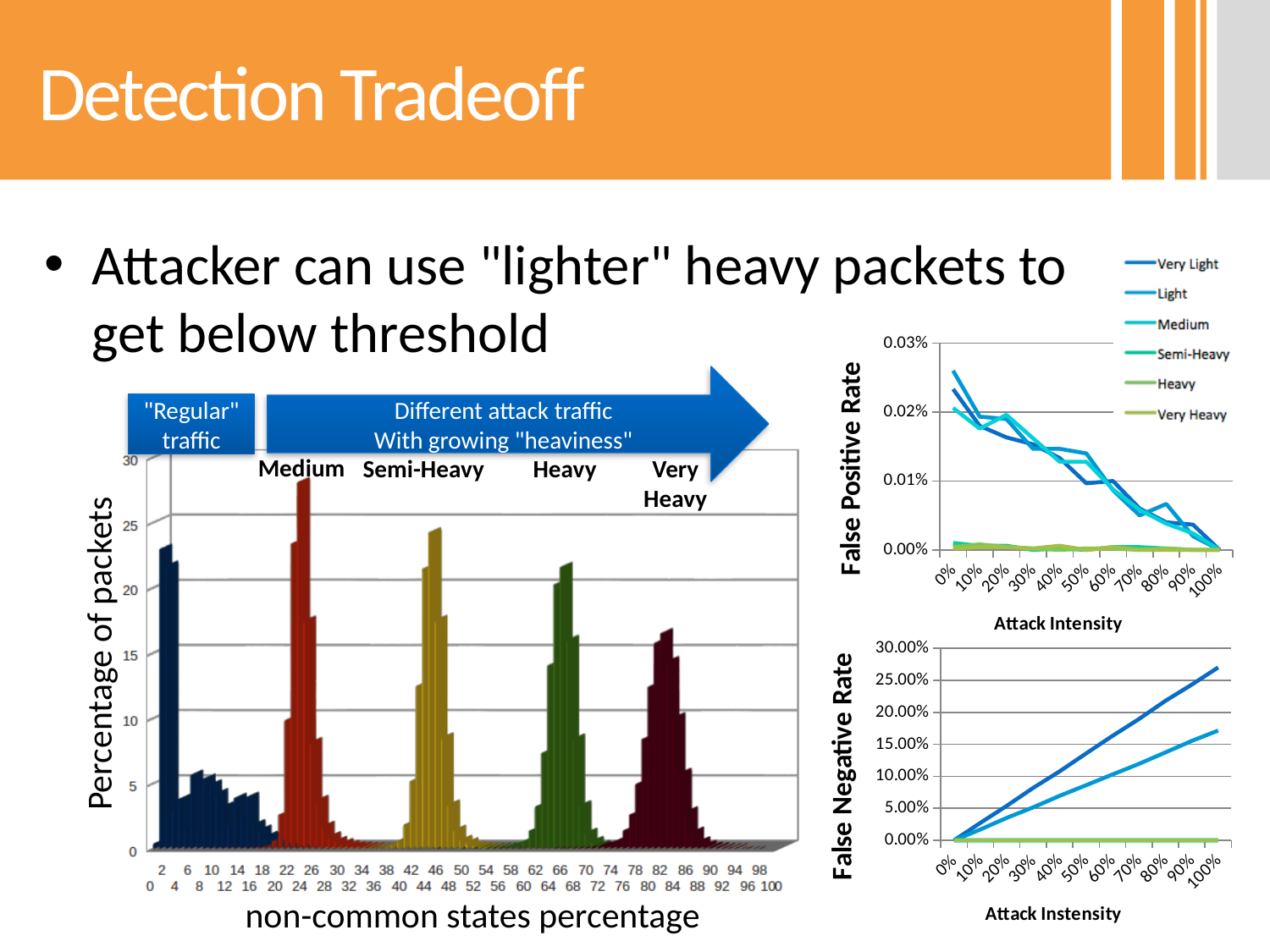
In the False Negative Rate chart, which is larger at 100% attack intensity: Very Light or Light? Very Light In the left bar chart, is the tallest Very Heavy bar greater or less than 20? less In the False Negative Rate chart, is the value for Very Light at 100% attack intensity greater or less than 25.00%? greater What is the x-axis title of the left bar chart? non-common states percentage In the left bar chart, which traffic category has the tallest bar? Medium In the False Positive Rate chart, is the value for Very Light at 0% attack intensity greater or less than 0.02%? greater In the False Negative Rate chart, does the Very Light line rise or fall as Attack Intensity increases? rise In the False Positive Rate chart, does the Very Light line rise or fall as Attack Intensity increases? fall How many series does the legend at the top right of the slide list? 6 In the False Positive Rate chart, how many Attack Intensity points are marked along the x axis? 11 What kind of chart is the large chart on the left of the slide? bar chart